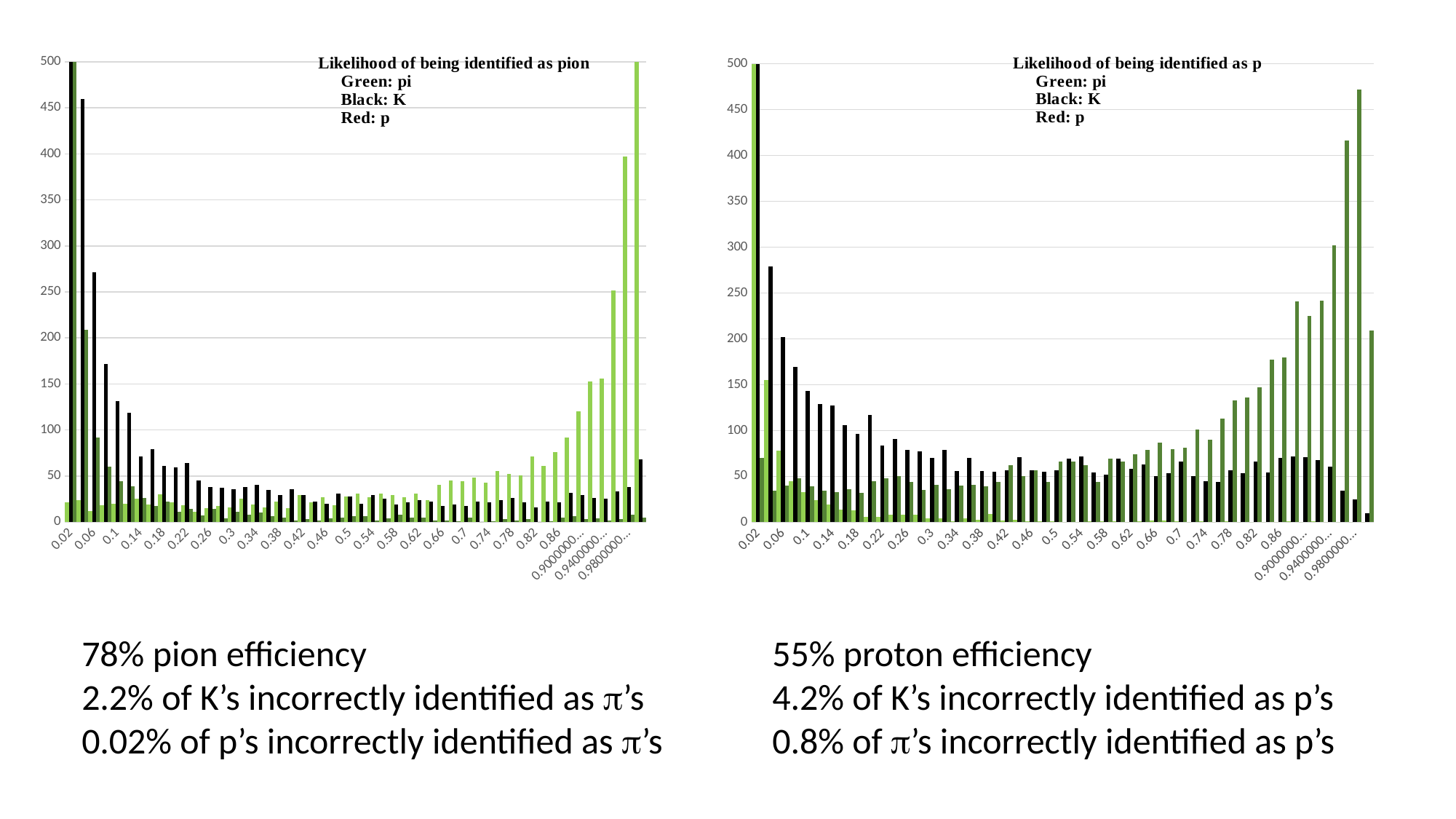
In the chart titled 'Likelihood of being identified as pion', is the light green bar at 0.94 greater or less than 350? less In the chart titled 'Likelihood of being identified as pion', at 0.06, which is larger: the black bar or the light green bar? the black bar What is the title of the chart on the right? Likelihood of being identified as p In the chart titled 'Likelihood of being identified as pion', do the black bars rise or fall from 0.02 to 0.26? fall What kind of chart is shown on the left of the slide? bar chart What is the title of the chart on the left? Likelihood of being identified as pion In the chart titled 'Likelihood of being identified as pion', is the black bar at 0.06 greater or less than 400? less In the chart titled 'Likelihood of being identified as pion', how many series does the legend text list? 3 In the chart titled 'Likelihood of being identified as p', is the black bar at 0.06 greater or less than 250? less In the chart titled 'Likelihood of being identified as pion', at which x-axis value is the black bar tallest? 0.02 In the chart titled 'Likelihood of being identified as p', at which x-axis value is the black bar tallest? 0.02